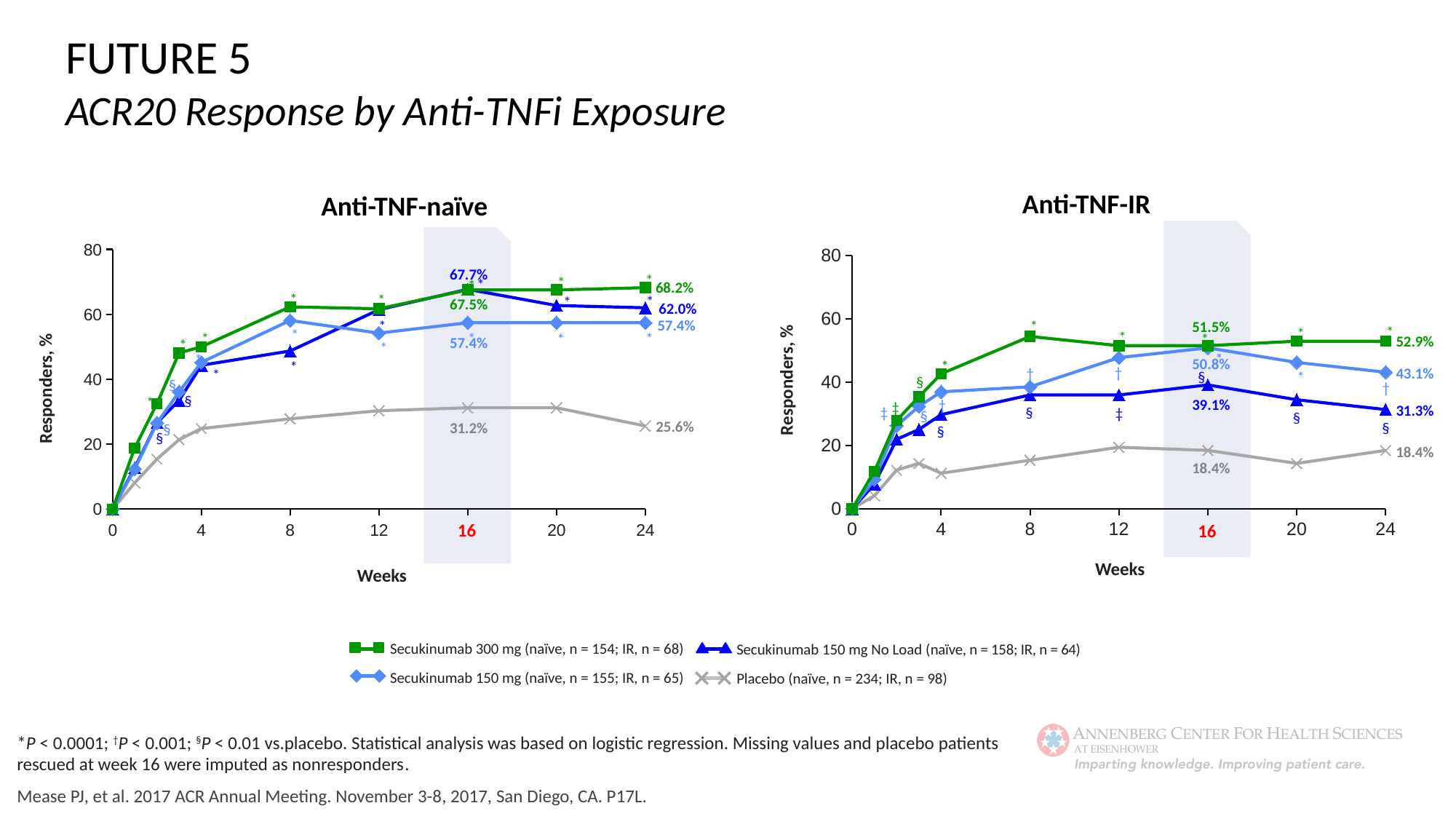
In the Anti-TNF-IR chart, what is the difference between the Secukinumab 150 mg and Secukinumab 150 mg No Load responses at week 24? 11.8% In the Anti-TNF-IR chart, is the Secukinumab 300 mg response at week 8 greater or less than 40? greater In the Anti-TNF-naïve chart, which series has the lowest response at week 24? Placebo In the Anti-TNF-IR chart, what is the response for Secukinumab 150 mg at week 16? 50.8% What type of chart is used for the Anti-TNF-naïve panel? Line chart In the Anti-TNF-naïve chart, what is the placebo response at week 16? 31.2% In the Anti-TNF-naïve chart, what is the ACR20 response for Secukinumab 300 mg at week 24? 68.2% In the Anti-TNF-IR chart, what is the response for Secukinumab 150 mg No Load at week 24? 31.3% In the Anti-TNF-naïve chart, what is the difference between the Secukinumab 300 mg and placebo responses at week 24? 42.6% How many series does the legend list? 4 In the Anti-TNF-naïve chart, does the placebo response rise or fall between week 20 and week 24? Fall In the Anti-TNF-IR chart, which series has the highest response at week 24? Secukinumab 300 mg